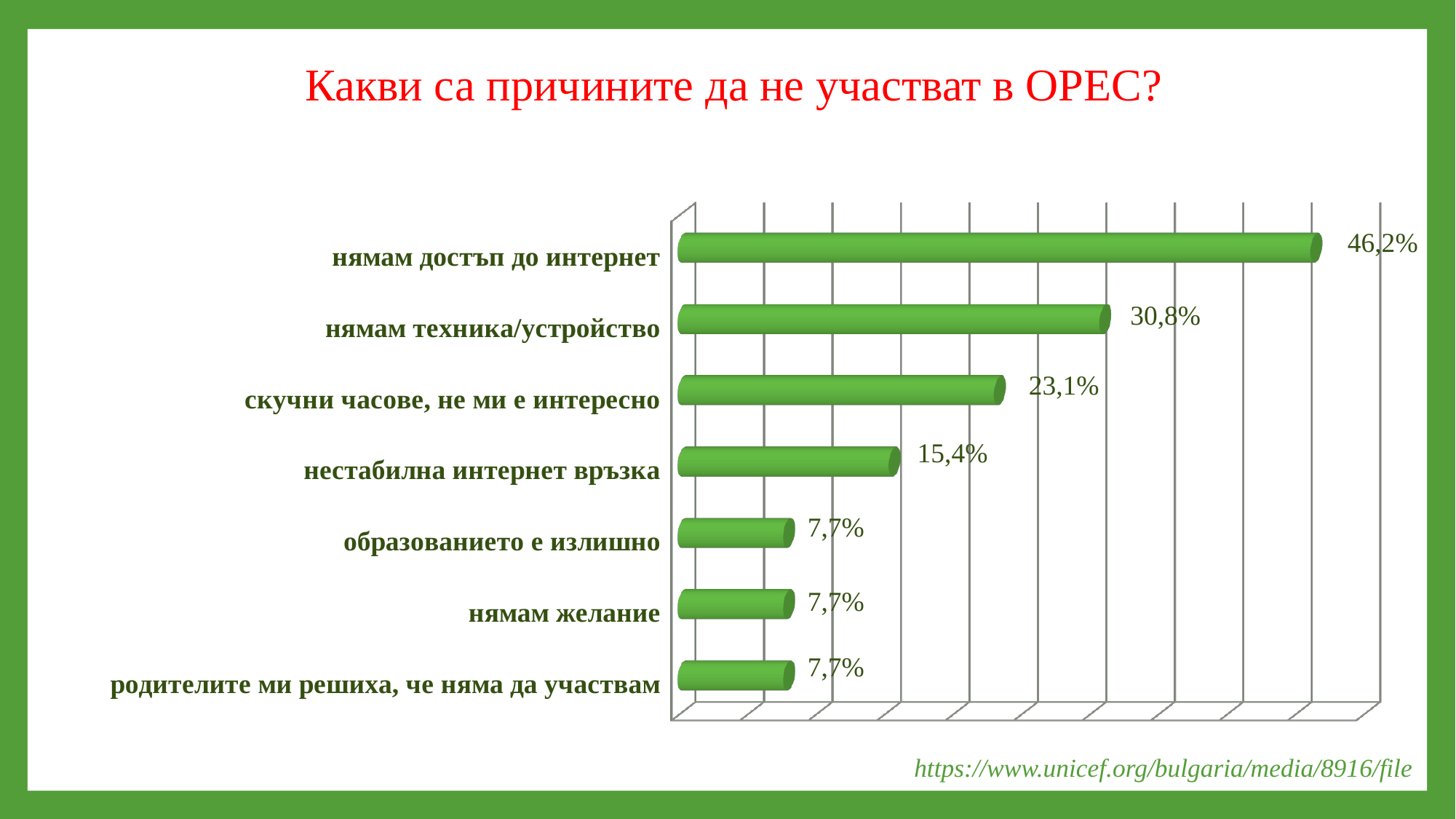
Which is larger, the value for "нямам техника/устройство" or the value for "скучни часове, не ми е интересно"? нямам техника/устройство What is the value for "нямам достъп до интернет"? 46,2% What is the difference between the values for "скучни часове, не ми е интересно" and "нестабилна интернет връзка"? 7,7% What is the value for "нестабилна интернет връзка"? 15,4% What kind of chart is shown on the slide? bar chart What is the title of the slide? Какви са причините да не участват в ОРЕС? What is the value for "скучни часове, не ми е интересно"? 23,1% What is the value for "нямам желание"? 7,7% Which category has the highest value? нямам достъп до интернет What is the difference between the values for "нямам достъп до интернет" and "нямам техника/устройство"? 15,4% What is the value for "нямам техника/устройство"? 30,8% How many categories are shown in the chart? 7